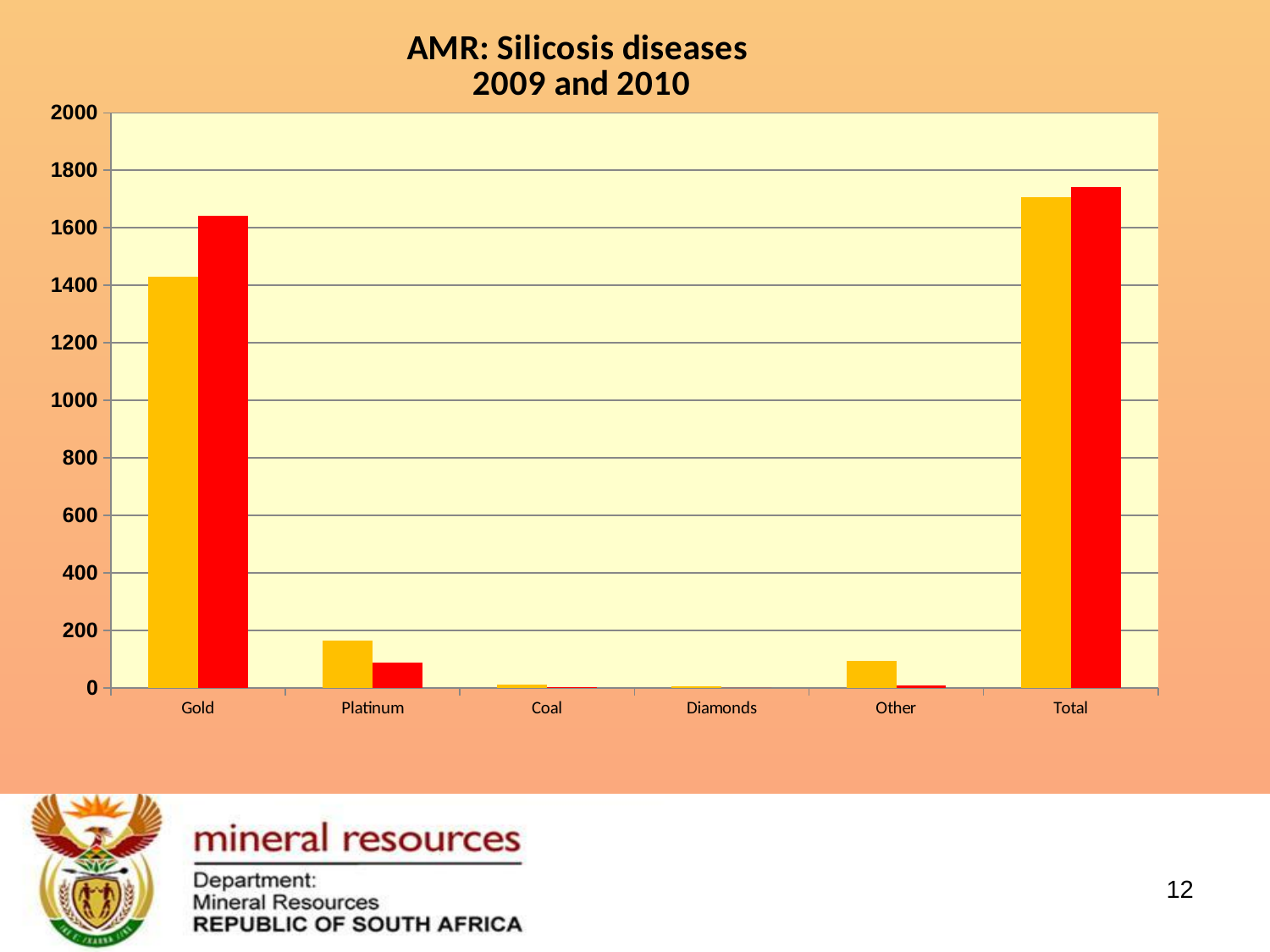
Is the red bar for Total greater or less than 1800? less For Platinum, which bar is larger, the yellow bar or the red bar? the yellow bar What is the title of the chart? AMR: Silicosis diseases 2009 and 2010 For Gold, which bar is larger, the yellow bar or the red bar? the red bar Is the yellow bar for Platinum greater or less than 200? less Is the yellow bar for Total greater or less than 1600? greater What kind of chart is shown on the slide? bar chart How many categories are shown on the x axis of the chart? 6 Excluding Total, which commodity category has the highest bars? Gold Which category has the lowest bars in the chart? Diamonds Which category has the highest bars in the chart? Total